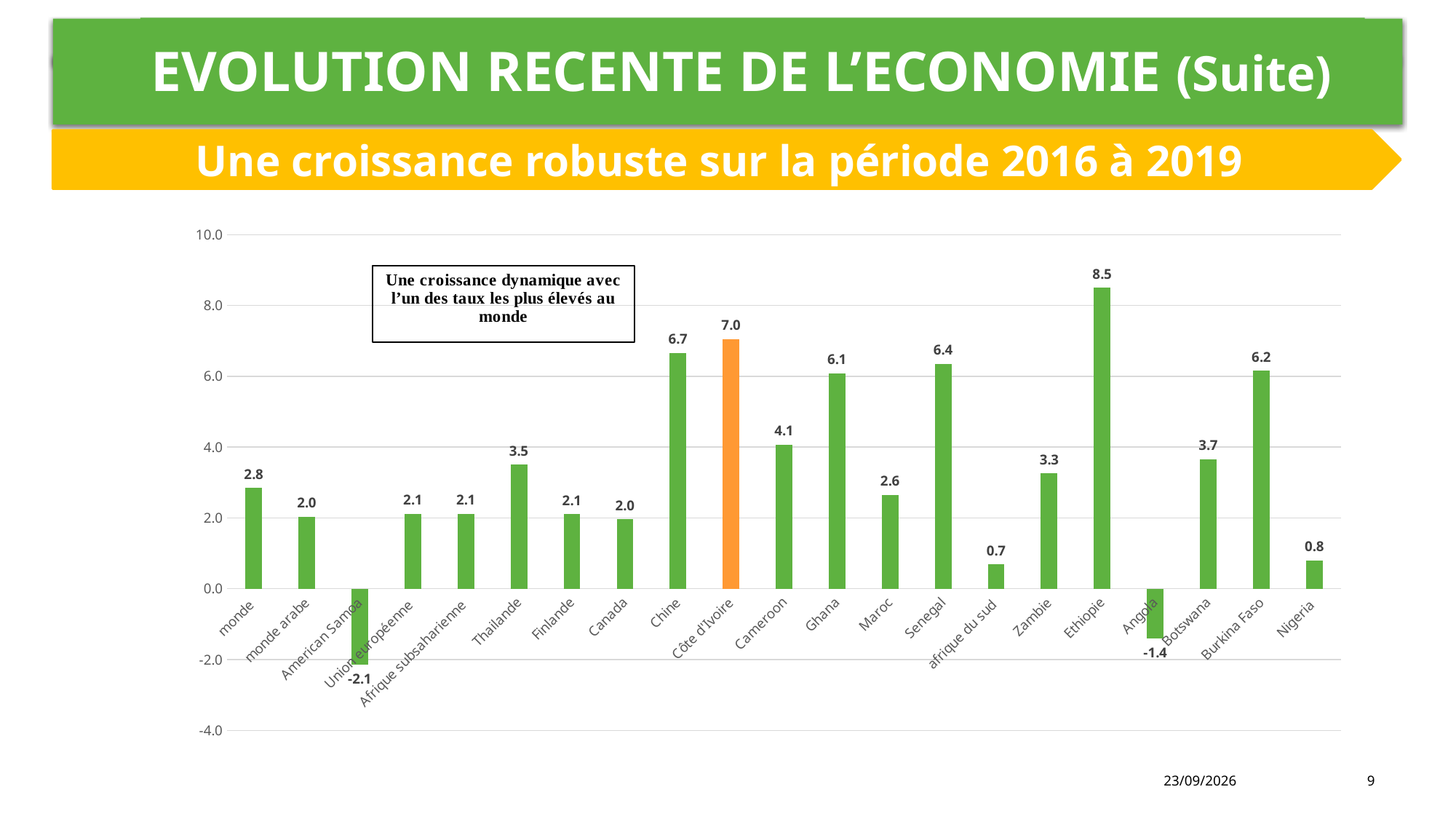
What is the value for Senegal? 6.4 How many categories are shown on the x axis? 21 What is the difference between the values for Ethiopie and Côte d'Ivoire? 1.5 What is the difference between the values for Côte d'Ivoire and Cameroon? 2.9 What is the value for American Samoa? -2.1 Which category has the highest value? Ethiopie Which is larger, the value for Chine or the value for Ghana? Chine What kind of chart is shown on the slide? Bar chart What is the value for Côte d'Ivoire? 7.0 Which category has the lowest value? American Samoa Which bar is coloured orange instead of green? Côte d'Ivoire What is the value for Ethiopie? 8.5